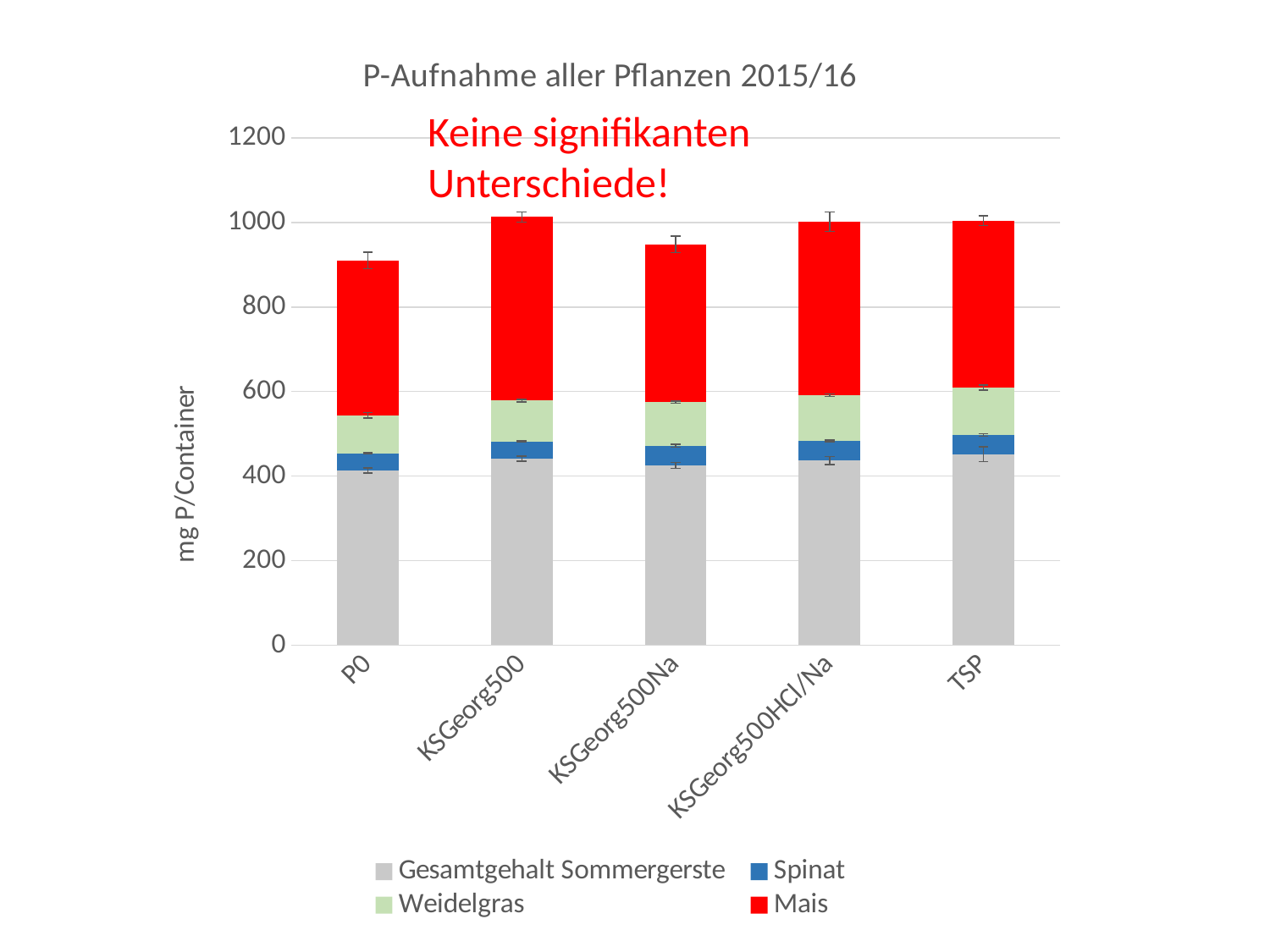
What is the title of the chart? P-Aufnahme aller Pflanzen 2015/16 Is the total value for TSP greater or less than 800? greater How many categories are shown on the x axis? 5 Which category has the lowest total bar? P0 Is the total value for KSGeorg500Na greater or less than 1000? less Is the Gesamtgehalt Sommergerste value for TSP greater or less than 600? less How many series does the legend list? 4 What kind of chart is shown on the slide? Stacked bar chart Which has the larger total bar, P0 or KSGeorg500? KSGeorg500 What is the label of the y axis? mg P/Container